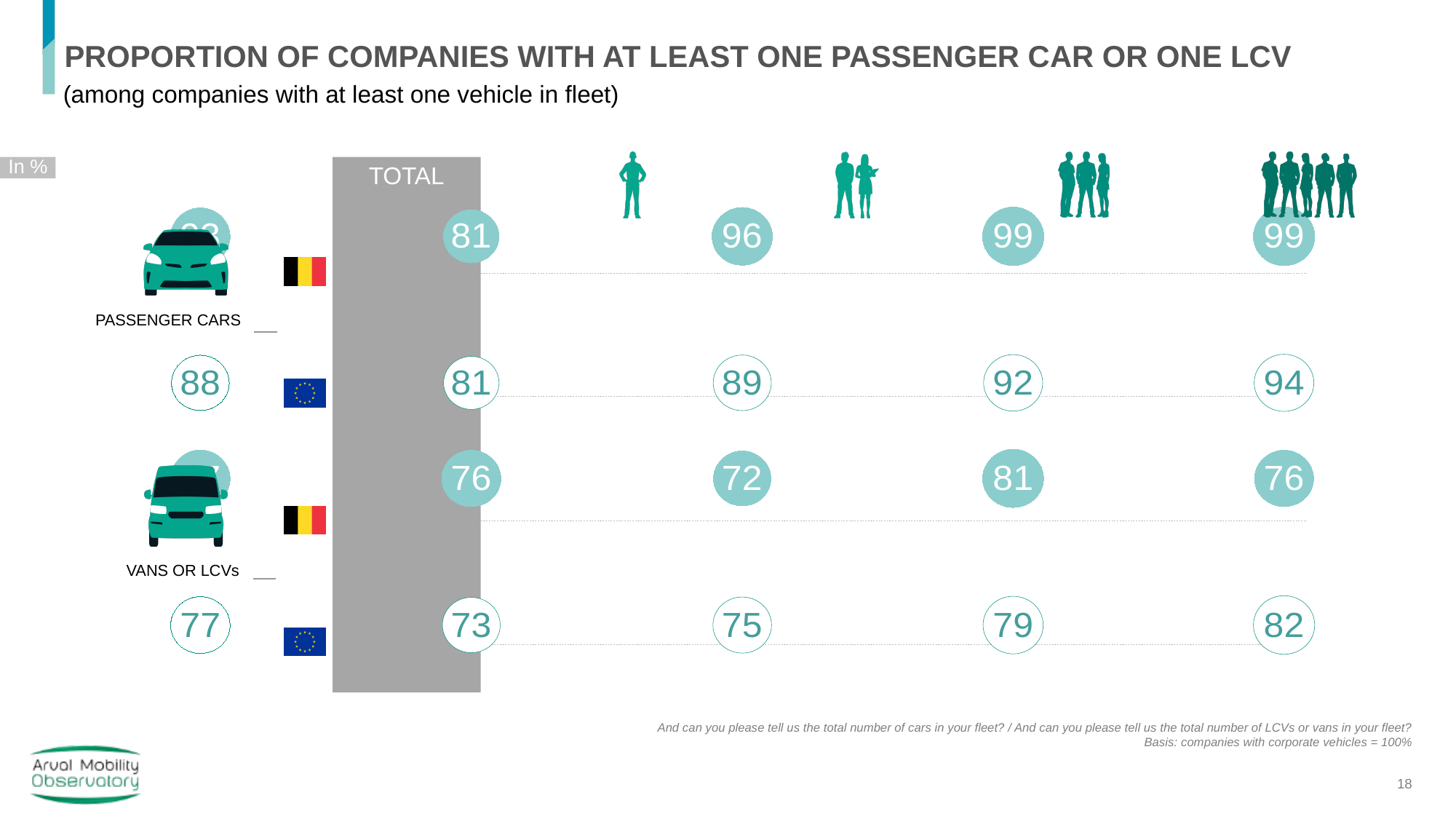
What is the value in the third column (three-person icon) for vans or LCVs in the Belgium row? 81 What is the TOTAL value for passenger cars in the Belgium (Belgian flag) row? 81 In what unit are the values on the slide expressed? In % What is the difference between the rightmost column value and the TOTAL value for passenger cars in the EU row? 13 What is the difference between the TOTAL value for vans or LCVs in the Belgium row and in the EU row? 3 How many columns of values are shown for each row, including the TOTAL column? 5 In the EU row for vans or LCVs, which column has the highest value? The rightmost column (82) Do the passenger car values in the EU row rise or fall from the TOTAL column to the rightmost column? Rise What is the value in the rightmost column for passenger cars in the EU row? 94 In the Belgium row for vans or LCVs, what is the lowest value shown? 72 In the second column (single-person icon), is the passenger cars value higher for the Belgium row or the EU row? Belgium row What is the TOTAL value for vans or LCVs in the EU (EU flag) row? 73